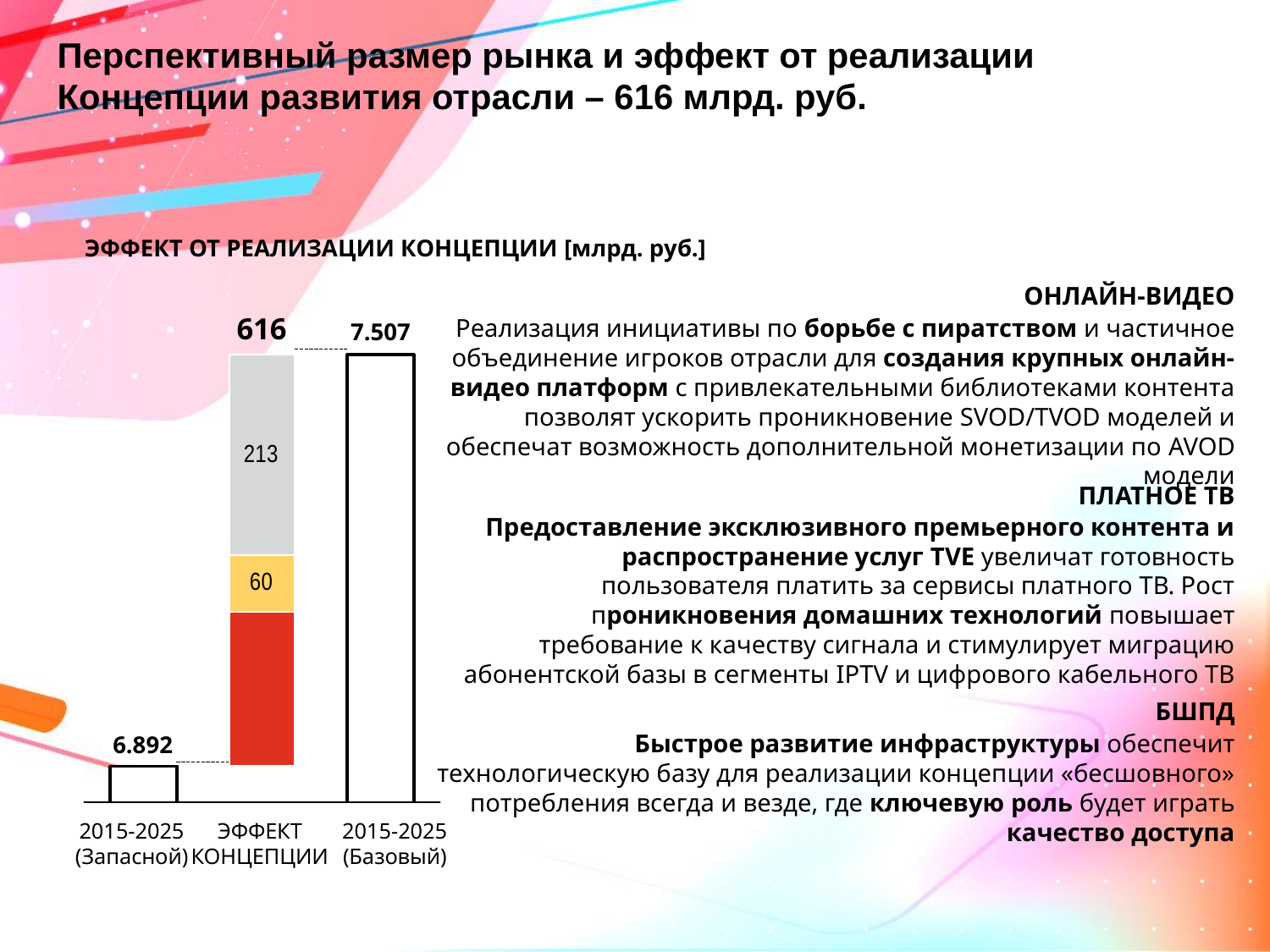
In what units are the chart values expressed, according to the chart title? млрд. руб. What is the value for the 2015-2025 (Запасной) bar? 6.892 How many categories are shown on the x axis of the chart? 3 What is the difference between the grey segment (213) and the yellow segment (60) of the ЭФФЕКТ КОНЦЕПЦИИ bar? 153 What kind of chart is shown on the slide? Bar chart What is the title of the chart? ЭФФЕКТ ОТ РЕАЛИЗАЦИИ КОНЦЕПЦИИ [млрд. руб.] Which labelled segment of the ЭФФЕКТ КОНЦЕПЦИИ bar is larger, the grey one or the yellow one? The grey one (213) What value is printed on the yellow segment of the ЭФФЕКТ КОНЦЕПЦИИ bar? 60 Which is larger, the 2015-2025 (Базовый) bar or the 2015-2025 (Запасной) bar? 2015-2025 (Базовый) What value is printed on the grey segment of the ЭФФЕКТ КОНЦЕПЦИИ bar? 213 What total value is labelled above the ЭФФЕКТ КОНЦЕПЦИИ bar? 616 What is the value for the 2015-2025 (Базовый) bar? 7.507